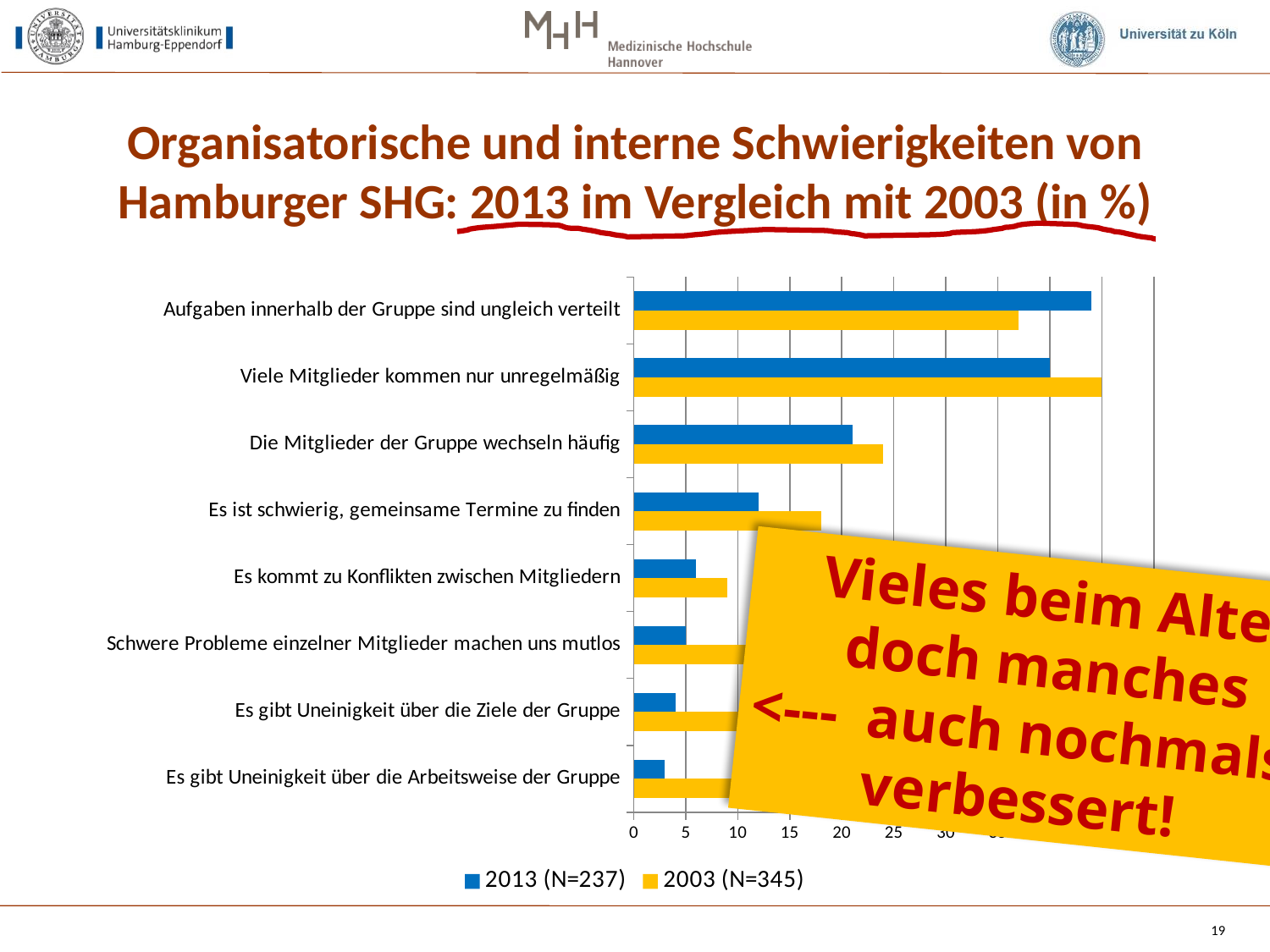
Is the 2013 (N=237) value for 'Die Mitglieder der Gruppe wechseln häufig' greater or less than 15? greater Which category has the highest value for the 2013 (N=237) series? Aufgaben innerhalb der Gruppe sind ungleich verteilt For 'Viele Mitglieder kommen nur unregelmäßig', which series has the larger value, 2013 (N=237) or 2003 (N=345)? 2003 (N=345) Which category has the highest value for the 2003 (N=345) series? Viele Mitglieder kommen nur unregelmäßig Which colour represents the 2003 (N=345) series in the chart? yellow How many categories are plotted on the chart? 8 Is the 2003 (N=345) value for 'Es ist schwierig, gemeinsame Termine zu finden' greater or less than 15? greater How many series does the legend list? 2 What kind of chart is shown on the slide? bar chart Is the 2013 (N=237) value for 'Es kommt zu Konflikten zwischen Mitgliedern' greater or less than 10? less For 'Aufgaben innerhalb der Gruppe sind ungleich verteilt', which series has the larger value, 2013 (N=237) or 2003 (N=345)? 2013 (N=237) Which category has the lowest value for the 2013 (N=237) series? Es gibt Uneinigkeit über die Arbeitsweise der Gruppe